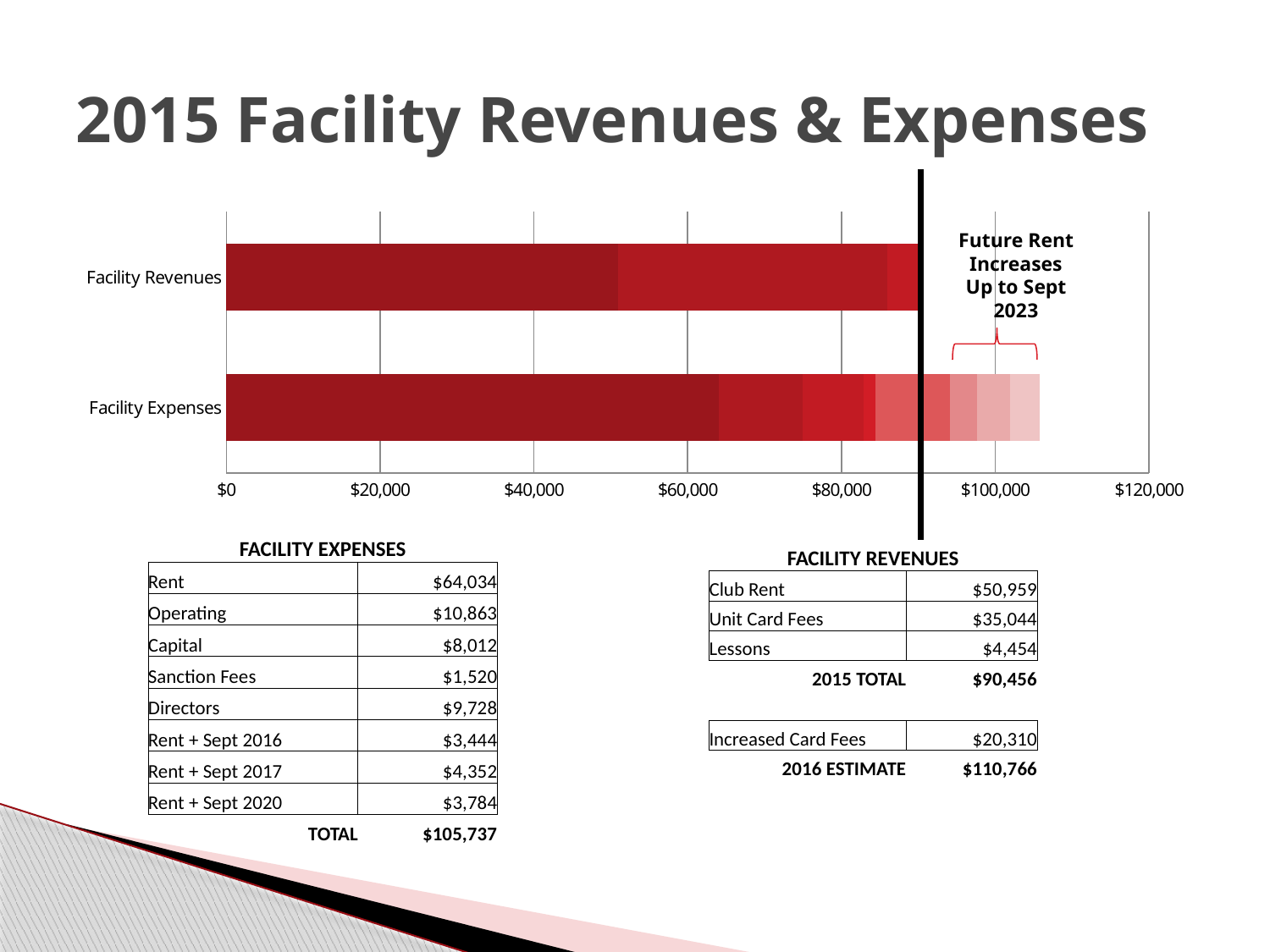
Using the totals printed in the tables, what is the difference between Facility Expenses and Facility Revenues? $15,281 How many categories are plotted on the bar chart? 2 According to the Facility Revenues table, what is the value for Unit Card Fees? $35,044 Is the total value of the Facility Revenues bar greater or less than $80,000? greater According to the Facility Expenses table, what is the total of the Facility Expenses bar? $105,737 According to the Facility Expenses table, which expense item is the largest? Rent Which bar is longer on the chart, Facility Revenues or Facility Expenses? Facility Expenses What does the annotation above the right end of the Facility Expenses bar say? Future Rent Increases Up to Sept 2023 Is the total value of the Facility Expenses bar greater or less than $100,000? greater What kind of chart is shown on the slide? bar chart According to the Facility Revenues table, what is the 2015 total of the Facility Revenues bar? $90,456 Is the total value of the Facility Revenues bar greater or less than $100,000? less